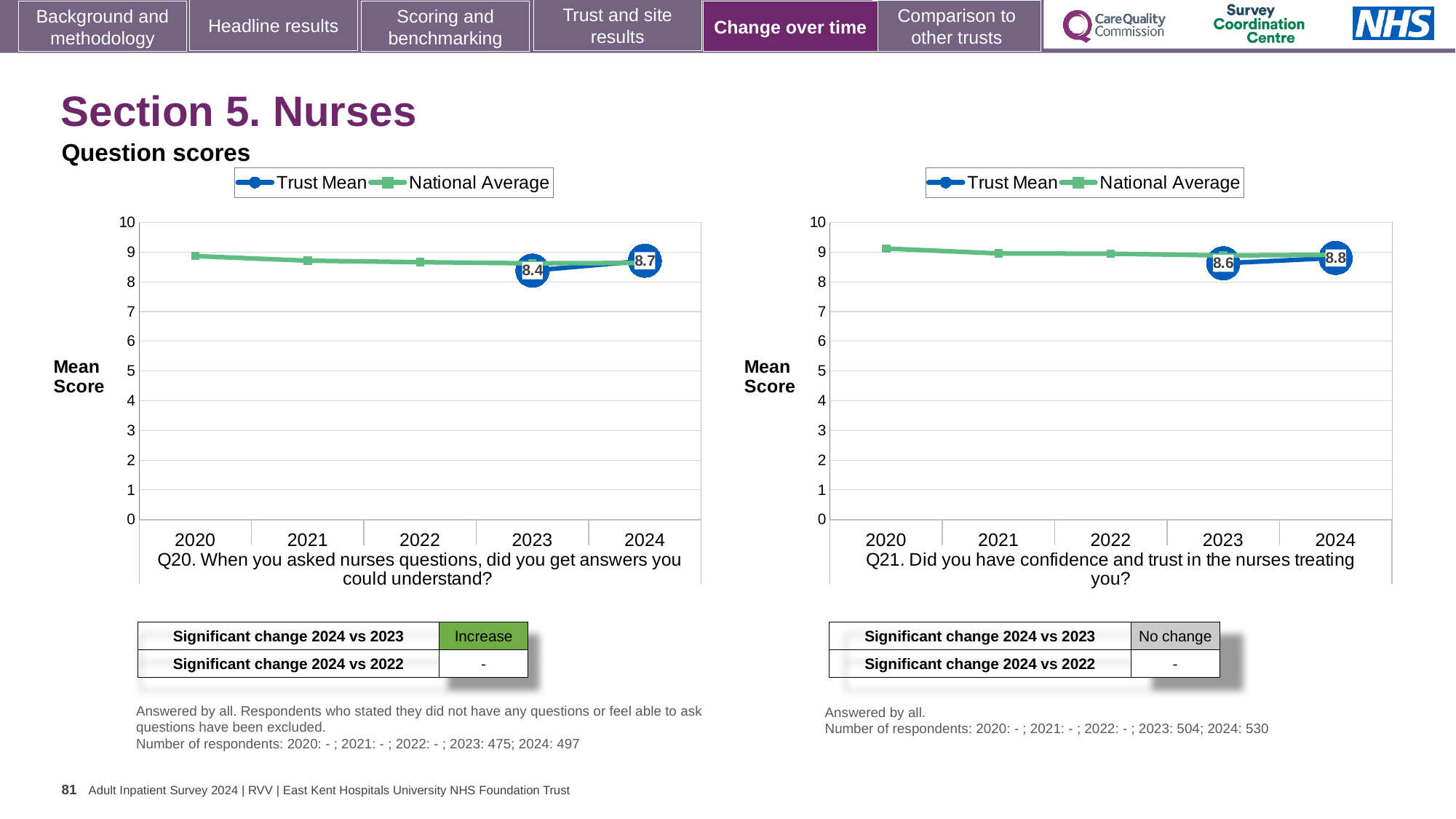
In the Q21 chart (right), what is the Trust Mean score for 2024? 8.8 In the Q21 chart (right), which series is shown in green? National Average In the Q21 chart (right), what is the difference between the Trust Mean in 2024 and 2023? 0.2 In the Q20 chart (left), by how much did the Trust Mean change from 2023 to 2024? 0.3 In the Q20 chart (left), did the Trust Mean rise or fall from 2023 to 2024? rise In the Q20 chart (left), what is the Trust Mean score for 2023? 8.4 How many years are shown on the x axis of the Q21 chart (right)? 5 In the Q20 chart (left), what is the Trust Mean score for 2024? 8.7 In the Q21 chart (right), what is the Trust Mean score for 2023? 8.6 In the Q21 chart (right), is the Trust Mean for 2024 greater or less than 8? greater What type of chart is used for Q20 (left)? line chart How many series does the legend of the Q20 chart (left) list? 2